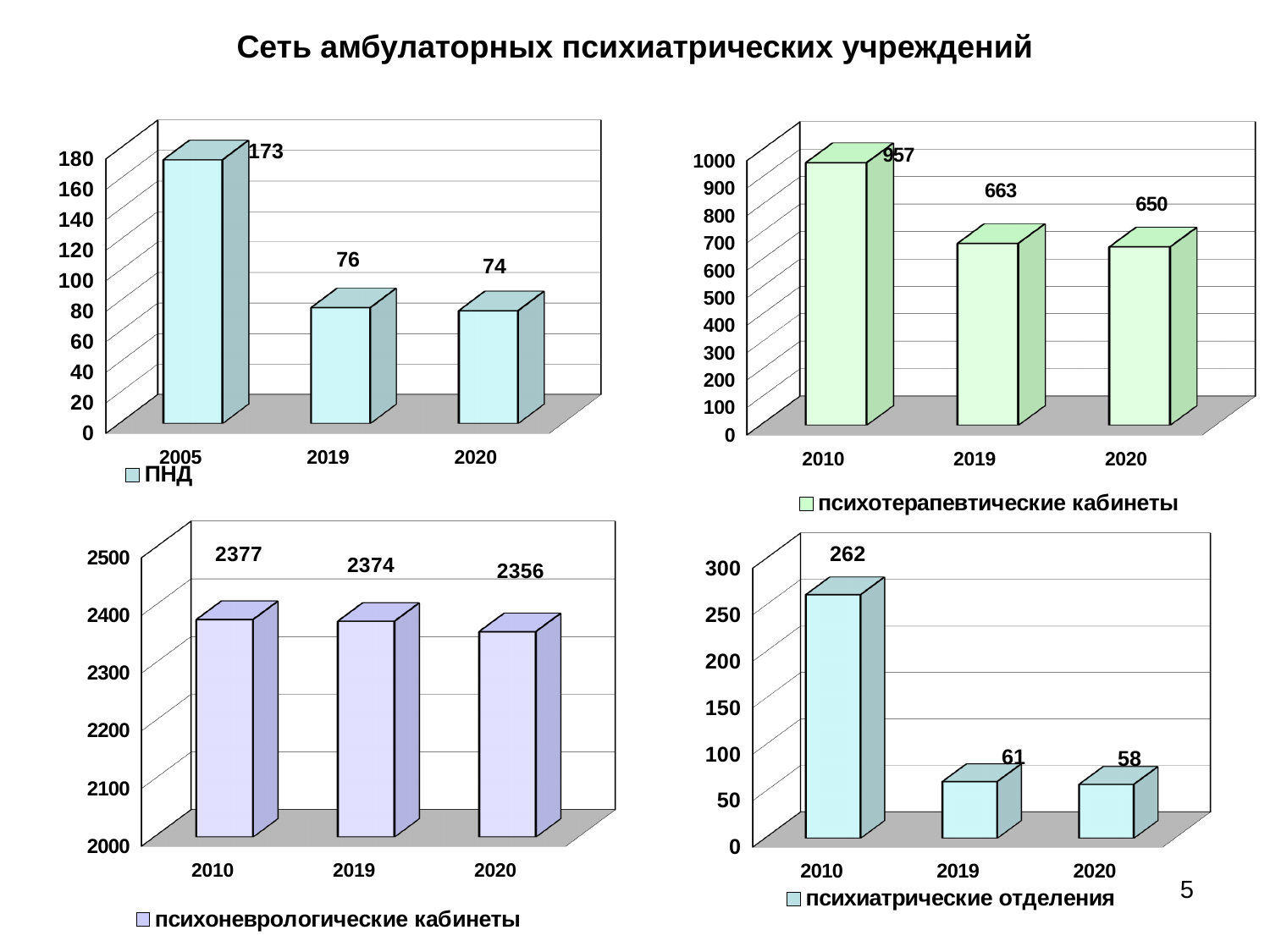
In the bottom-left chart (психоневрологические кабинеты), what is the value for 2020? 2356 In the bottom-left chart (психоневрологические кабинеты), which year has the lowest value? 2020 What kind of chart is the bottom-left chart (психоневрологические кабинеты)? bar chart In the bottom-right chart (психиатрические отделения), do the values rise or fall from 2010 to 2020? fall In the bottom-right chart (психиатрические отделения), which is larger, the value for 2019 or 2020? 2019 In the top-right chart (психотерапевтические кабинеты), what is the difference between the values for 2010 and 2020? 307 In the top-right chart (психотерапевтические кабинеты), what is the value for 2019? 663 In the top-left chart (ПНД), what is the value for 2005? 173 How many bars are in the top-left chart (ПНД)? 3 In the bottom-right chart (психиатрические отделения), what is the value for 2010? 262 In the top-right chart (психотерапевтические кабинеты), which year has the highest value? 2010 In the top-left chart (ПНД), what is the difference between the values for 2005 and 2020? 99